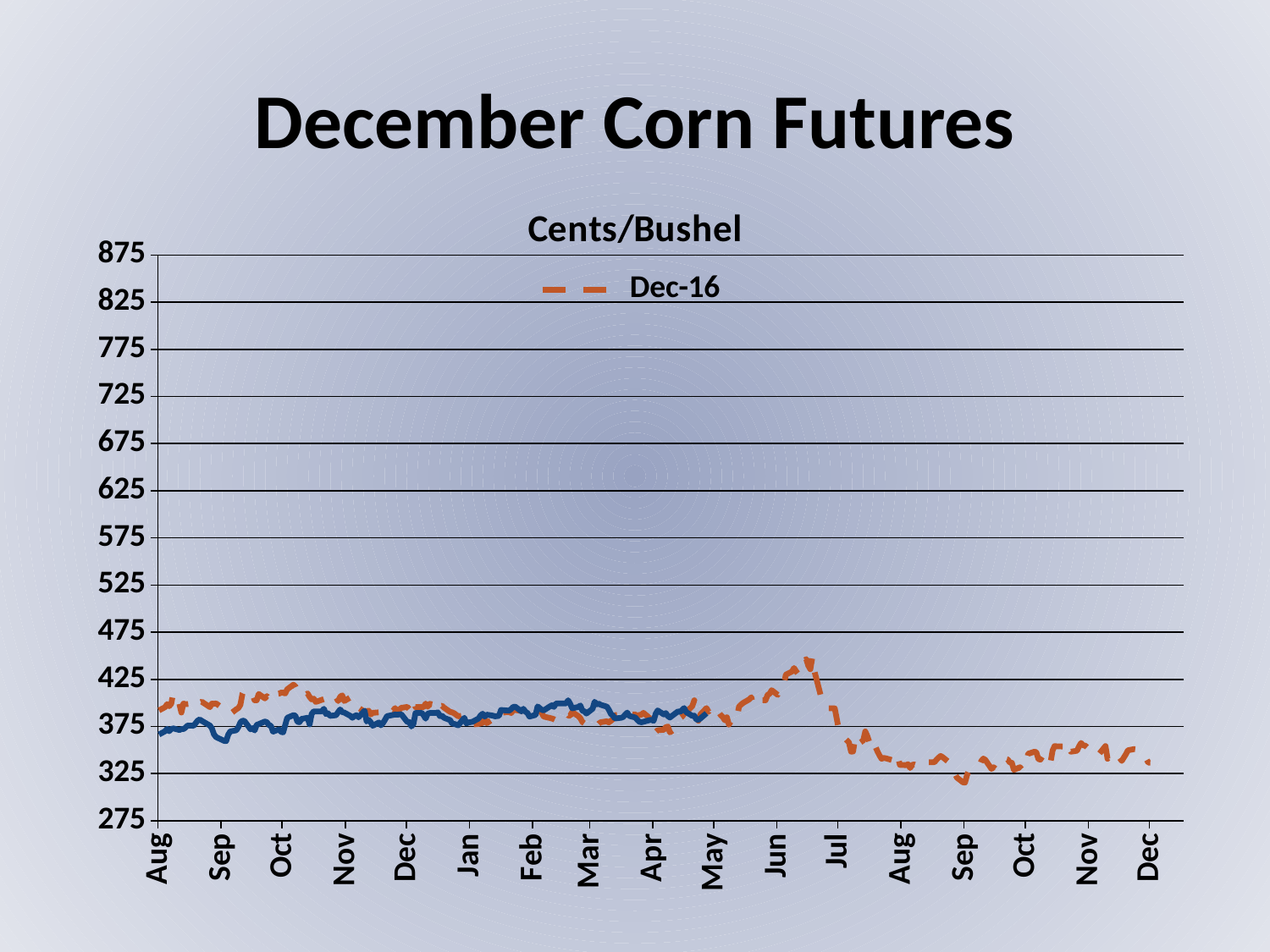
What is the title printed above the chart's plot area? Cents/Bushel What is the name of the series shown in the legend? Dec-16 Does the Dec-16 series rise or fall between Jul and the second Sep? fall How many series does the legend list? 1 Is the value of the Dec-16 series at the final Dec greater or less than 375? less How many month labels are shown along the x axis? 17 Around which month label does the Dec-16 series reach its lowest value? Sep Is the value of the Dec-16 series at the second Sep greater or less than 325? less What kind of chart is shown on the slide? line chart Is the peak value of the Dec-16 series between Jun and Jul greater or less than 425? greater Does the Dec-16 series rise or fall between May and Jun? rise